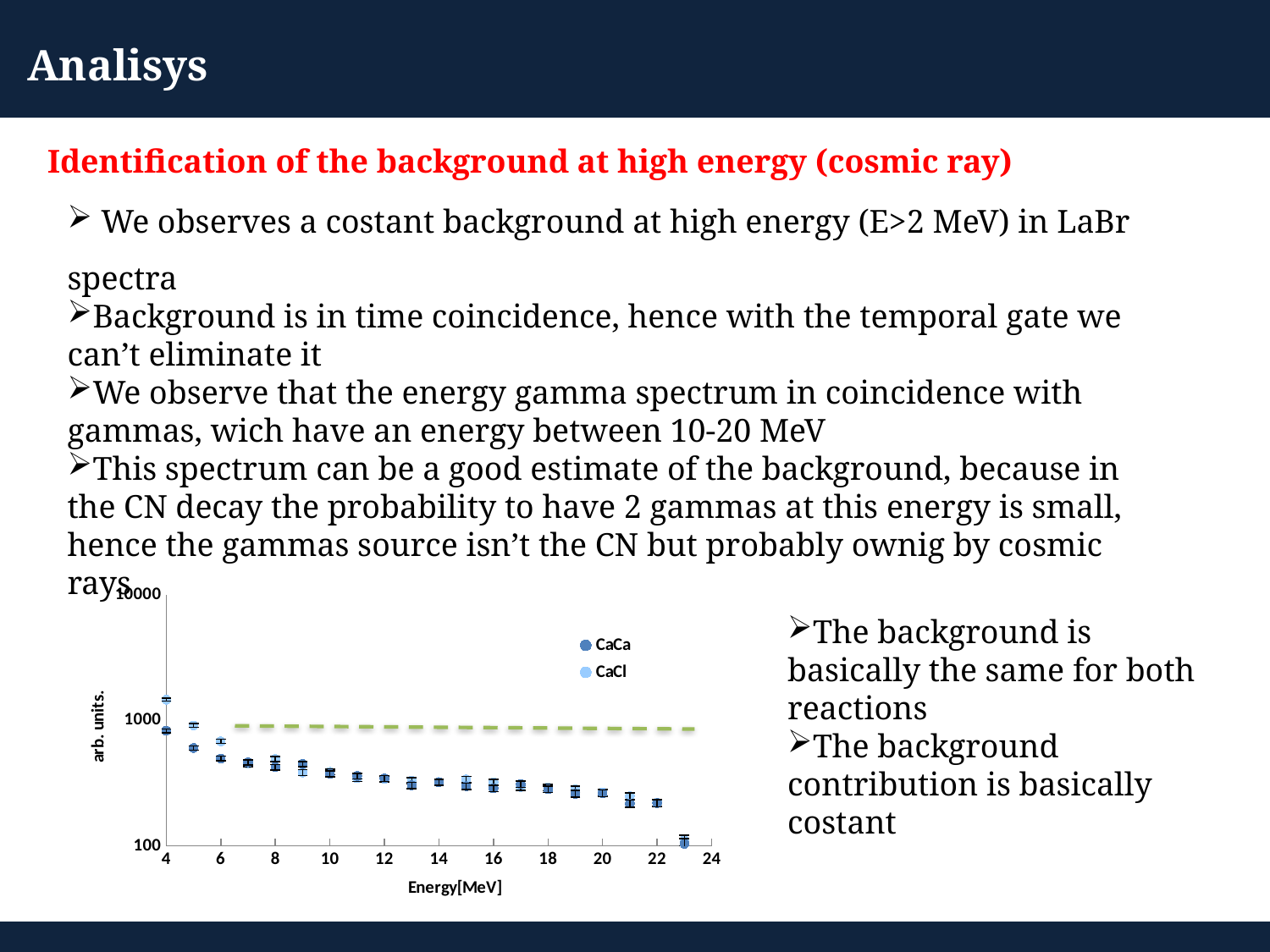
What is the label of the x axis of the chart? Energy[MeV] Is the CaCa value at 8 MeV greater or less than 1000? less Do the plotted values rise or fall as energy increases along the x axis? fall Is the CaCa value at 18 MeV greater or less than 1000? less How many series does the chart legend list? 2 What are the two series named in the chart legend? CaCa and CaCl Is the CaCl value at 4 MeV greater or less than 1000? greater Which energy has the highest plotted value, 4 MeV or 22 MeV? 4 MeV What kind of chart is shown on the slide? scatter chart